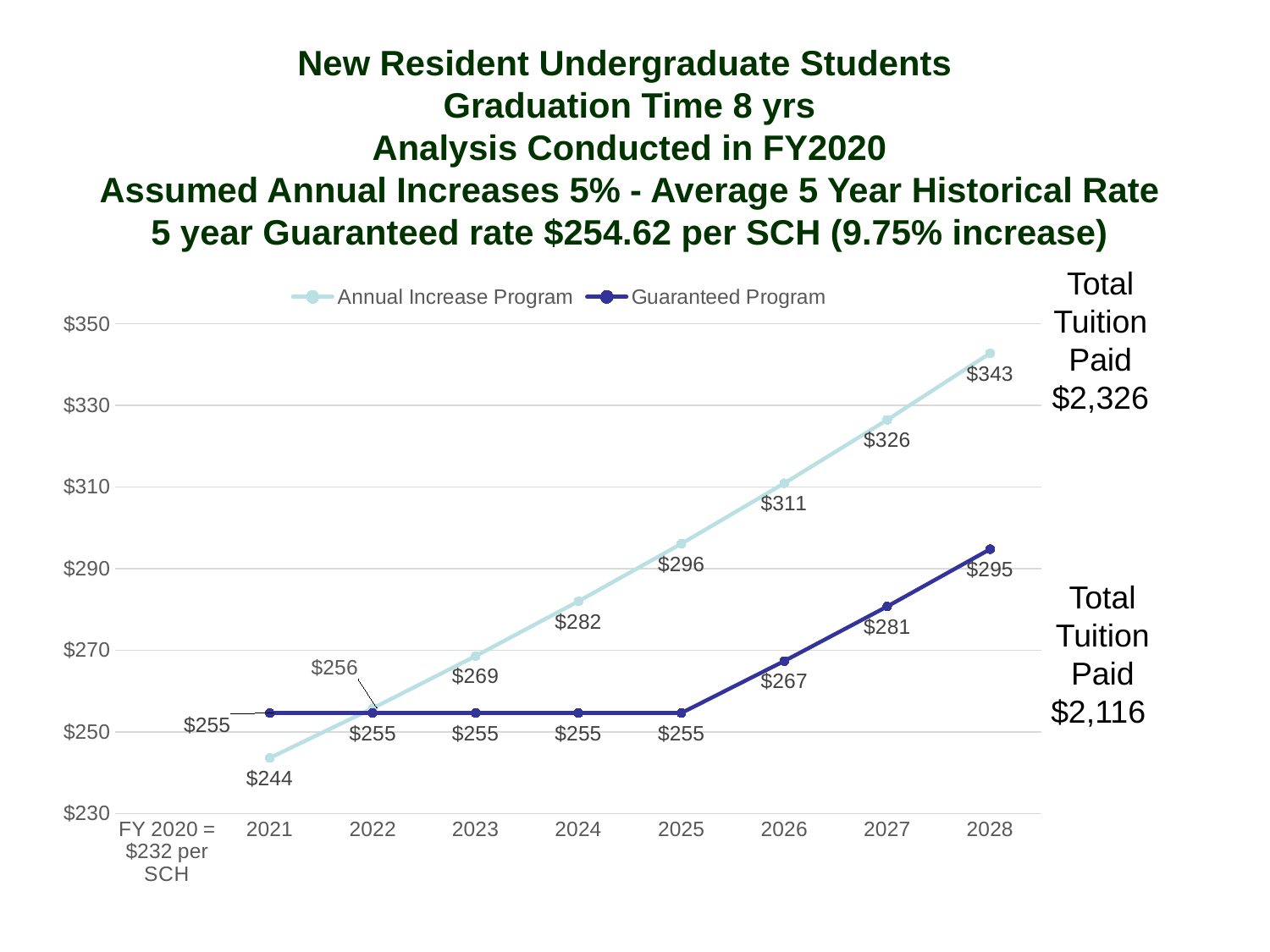
In which year is the Annual Increase Program value highest? 2028 In which year is the Annual Increase Program value lowest? 2021 How many data points does the Annual Increase Program line have? 8 What type of chart is shown on the slide? line chart What is the value for the Annual Increase Program in 2021? $244 What is the value for the Annual Increase Program in 2028? $343 What is the difference between the Annual Increase Program and the Guaranteed Program values in 2028? $48 How many series does the legend list? 2 Does the Annual Increase Program line rise or fall from 2021 to 2028? rise What is the Total Tuition Paid shown for the Guaranteed Program? $2,116 What is the value for the Guaranteed Program in 2027? $281 Which series has the larger value in 2026, Annual Increase Program or Guaranteed Program? Annual Increase Program